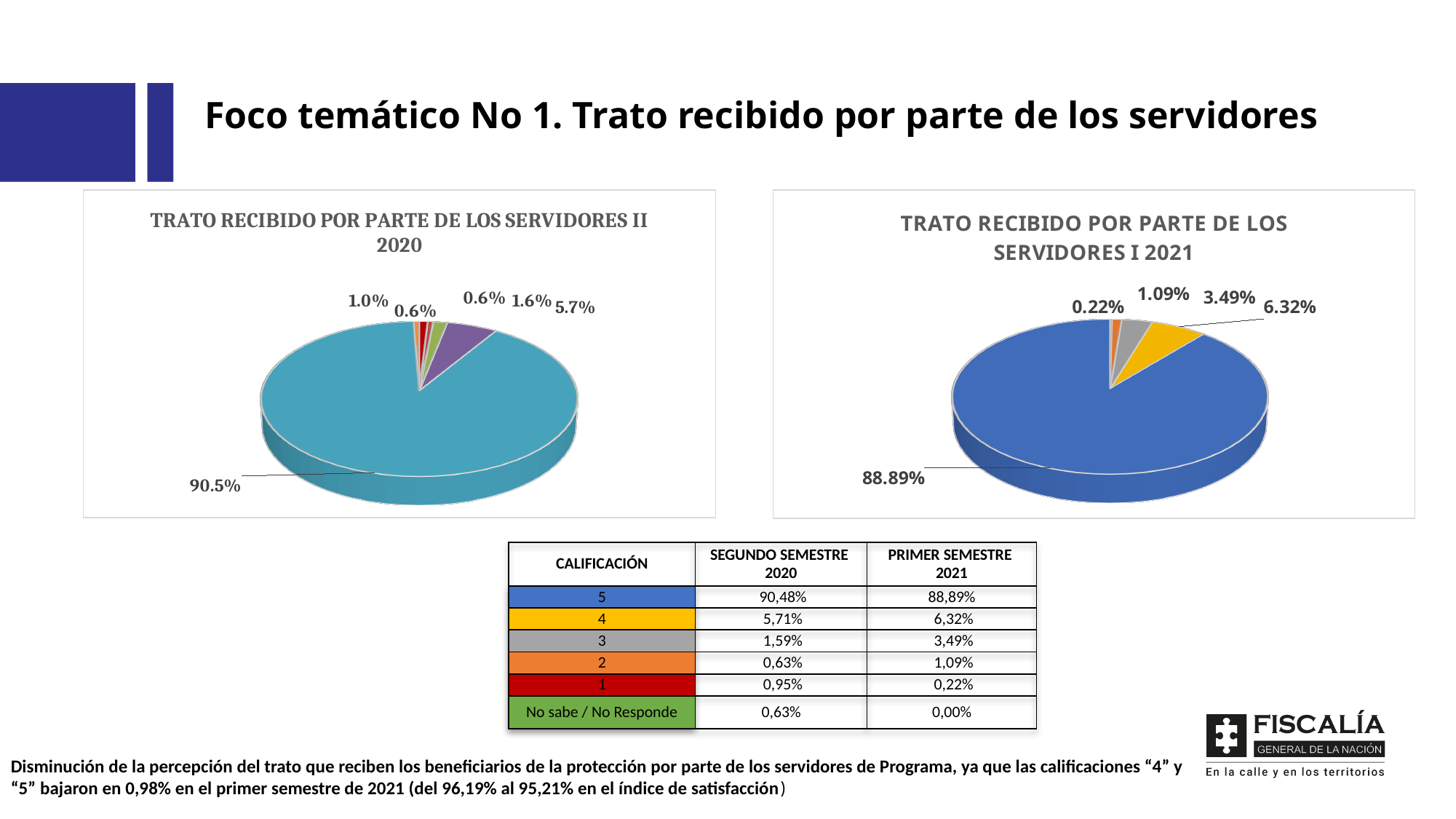
In the "TRATO RECIBIDO POR PARTE DE LOS SERVIDORES I 2021" chart, what is the difference between the largest slice (88.89%) and the yellow slice (6.32%)? 82.57% Which chart has the larger biggest slice: the II 2020 chart (90.5%) or the I 2021 chart (88.89%)? The II 2020 chart In the "TRATO RECIBIDO POR PARTE DE LOS SERVIDORES I 2021" chart, what is the value of the yellow slice? 6.32% In the "TRATO RECIBIDO POR PARTE DE LOS SERVIDORES I 2021" chart, what is the value of the largest slice? 88.89% What is the title of the pie chart on the right side of the slide? TRATO RECIBIDO POR PARTE DE LOS SERVIDORES I 2021 How many slices are labelled in the "TRATO RECIBIDO POR PARTE DE LOS SERVIDORES II 2020" chart? 6 In the "TRATO RECIBIDO POR PARTE DE LOS SERVIDORES I 2021" chart, what is the value of the smallest slice? 0.22% In the "TRATO RECIBIDO POR PARTE DE LOS SERVIDORES I 2021" chart, what is the value of the gray slice? 3.49% In the "TRATO RECIBIDO POR PARTE DE LOS SERVIDORES II 2020" chart, what is the value of the purple slice? 5.7% What kind of chart is the "TRATO RECIBIDO POR PARTE DE LOS SERVIDORES II 2020" chart? Pie chart How many slices are labelled in the "TRATO RECIBIDO POR PARTE DE LOS SERVIDORES I 2021" chart? 5 In the "TRATO RECIBIDO POR PARTE DE LOS SERVIDORES II 2020" chart, what is the value of the largest slice? 90.5%